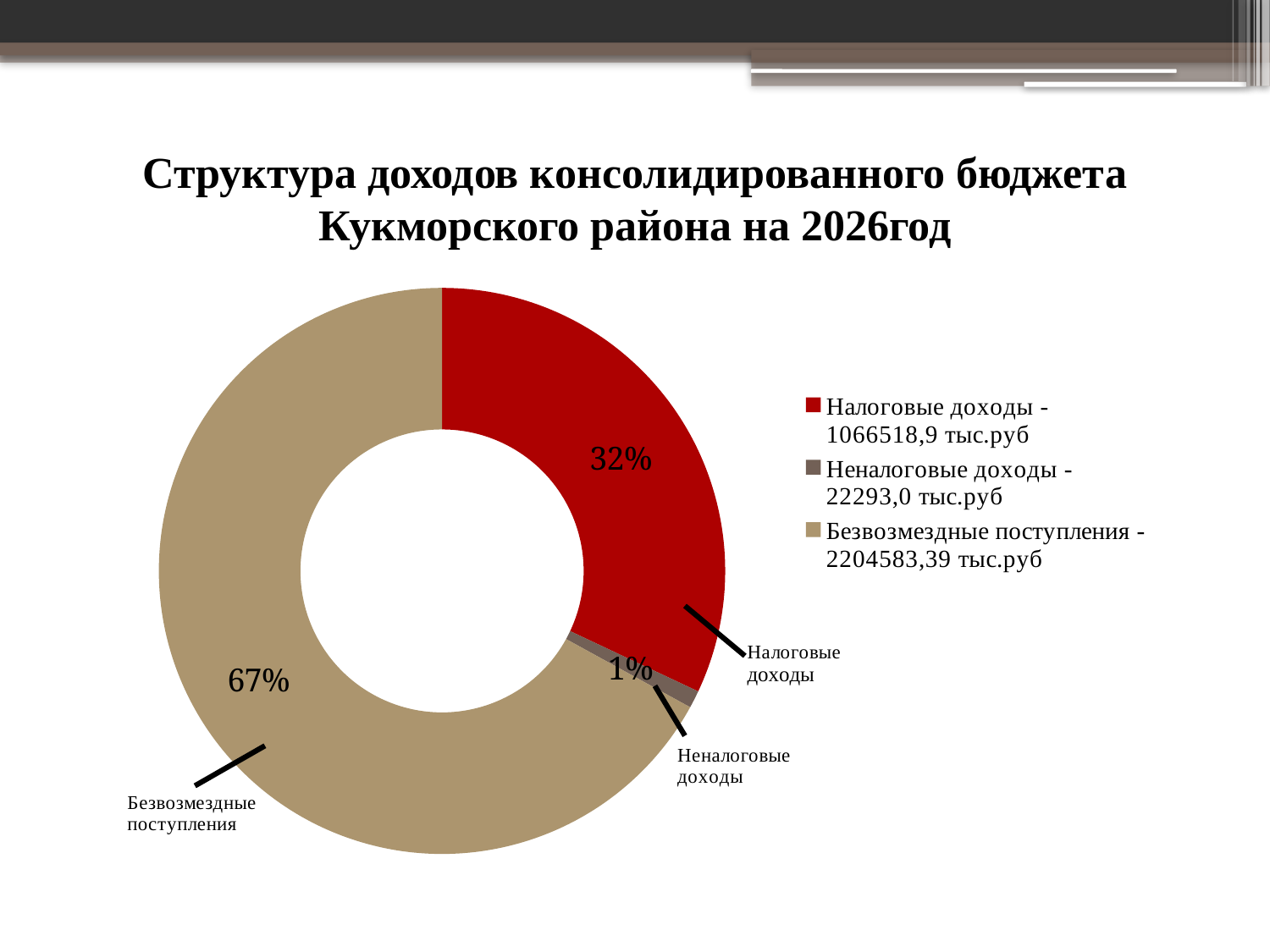
According to the legend, what is the amount for Налоговые доходы? 1066518,9 тыс.руб What kind of chart is shown on the slide? Doughnut (pie) chart What share of the doughnut chart does Безвозмездные поступления account for? 67% According to the legend, what is the amount for Безвозмездные поступления? 2204583,39 тыс.руб What colour represents Налоговые доходы in the chart? Red Which is larger: the share of Налоговые доходы or the share of Неналоговые доходы? Налоговые доходы What share of the doughnut chart does Неналоговые доходы account for? 1% Which category has the smallest share of the chart? Неналоговые доходы What share of the doughnut chart does Налоговые доходы account for? 32% How many categories are shown in the chart? 3 What is the difference in percentage points between the shares of Безвозмездные поступления and Налоговые доходы? 35 Which category has the largest share of the chart? Безвозмездные поступления